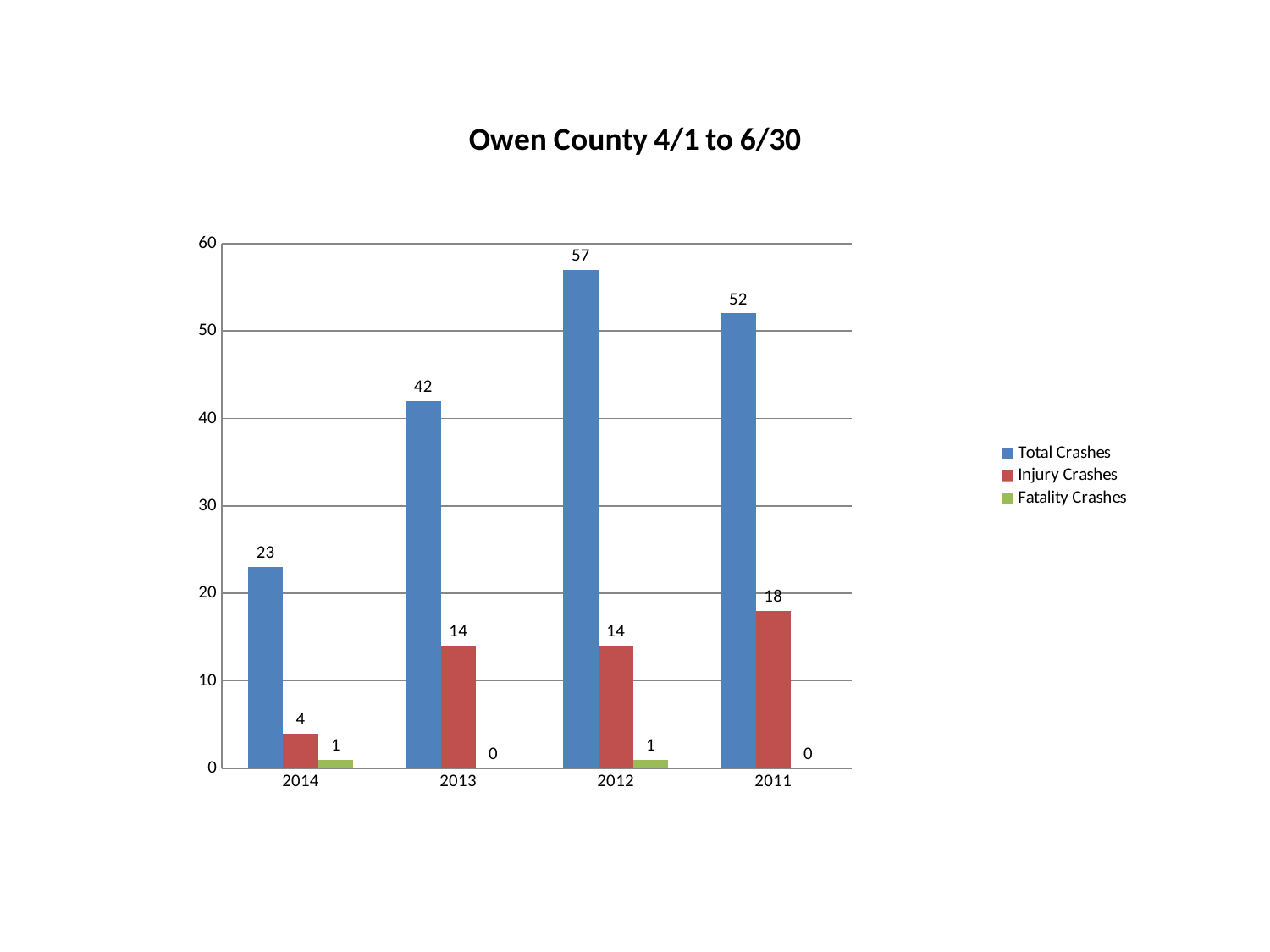
Which is larger, Total Crashes in 2013 or Total Crashes in 2011? 2011 Is the value of Total Crashes for 2013 greater or less than 40? greater What is the value of Fatality Crashes for 2014? 1 Which year has the lowest Injury Crashes? 2014 How many years are shown on the x axis? 4 What is the title of the chart? Owen County 4/1 to 6/30 What is the value of Injury Crashes for 2011? 18 What is the difference between Total Crashes in 2012 and 2014? 34 How many series does the legend list? 3 What is the value of Total Crashes for 2012? 57 What kind of chart is shown on the slide? bar chart Which year has the highest Total Crashes? 2012